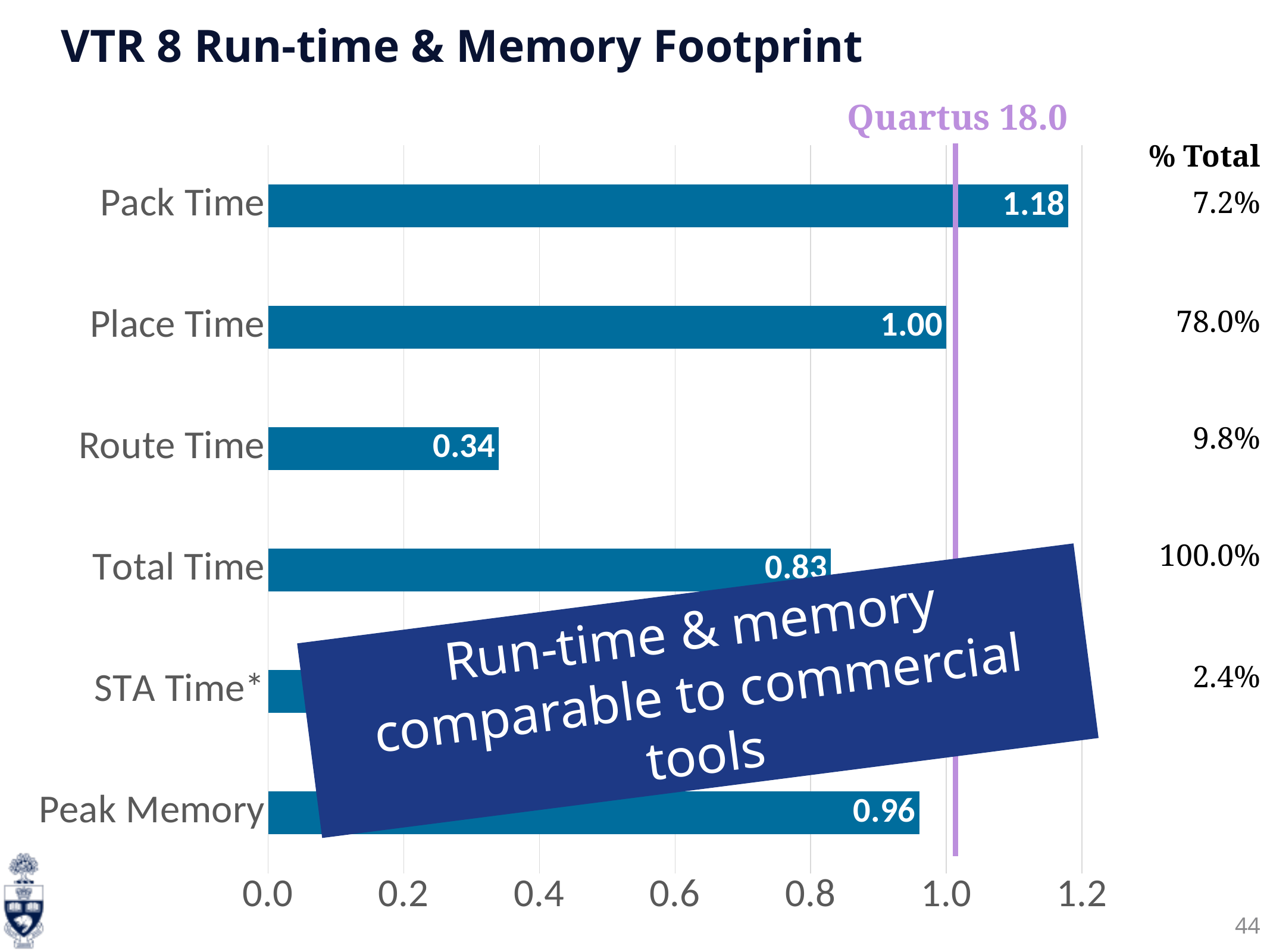
Which category has the highest value? Pack Time What label is given to the vertical purple reference line on the chart? Quartus 18.0 What is the value for Total Time? 0.83 Is the value for Route Time greater or less than 0.4? less What is the value for Route Time? 0.34 What % Total is shown for Place Time? 78.0% What is the value for Pack Time? 1.18 What is the value for Peak Memory? 0.96 What is the difference between the values for Pack Time and Place Time? 0.18 How many categories are shown on the chart? 6 What kind of chart is shown on the slide? bar chart Which is larger, the value for Peak Memory or the value for Total Time? Peak Memory